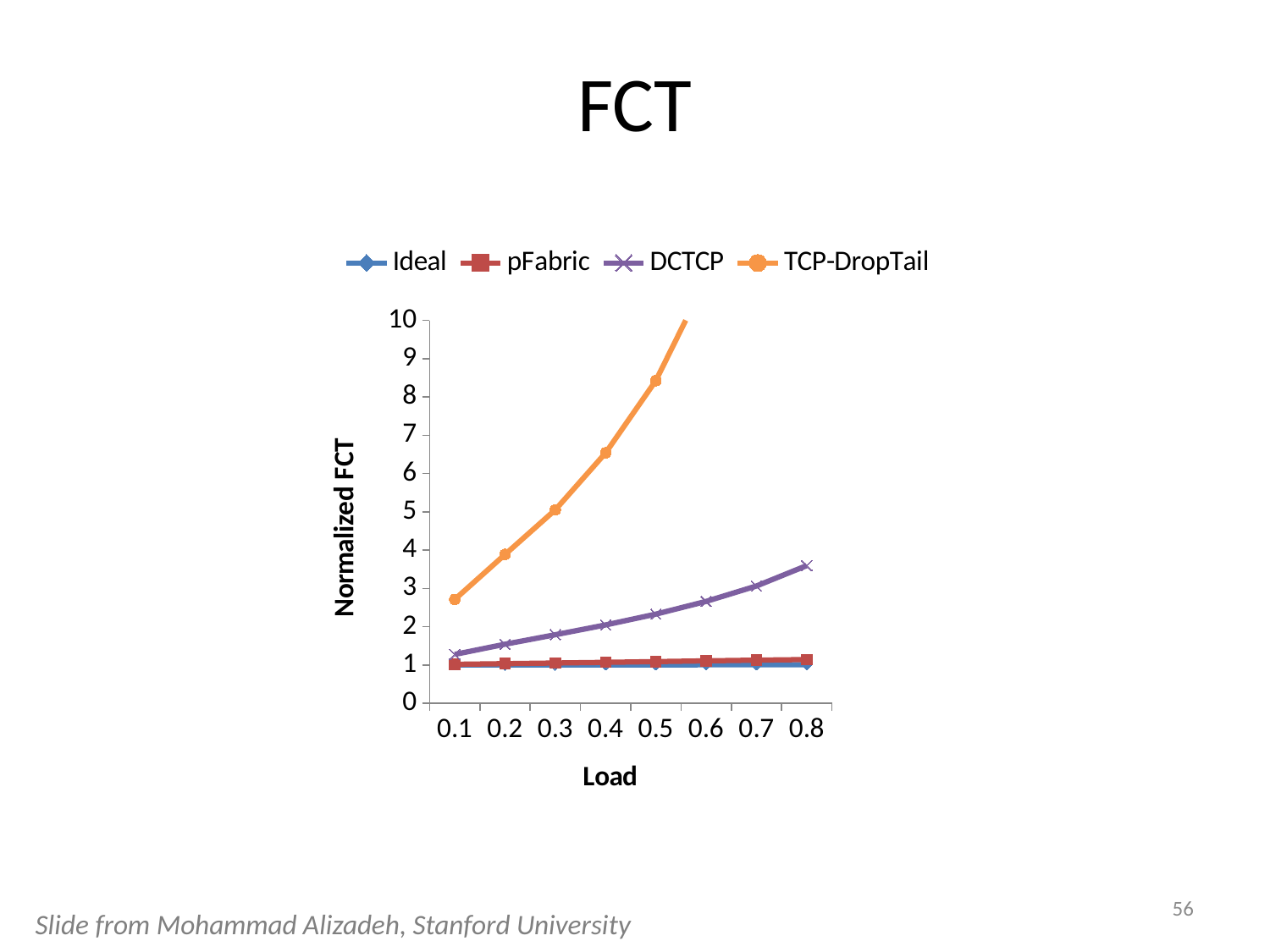
Is the Normalized FCT for TCP-DropTail at a Load of 0.5 greater or less than 8? greater How many Load values are marked on the x axis? 8 Is the Normalized FCT for DCTCP at a Load of 0.8 greater or less than 3? greater Is the Normalized FCT for DCTCP at a Load of 0.1 greater or less than 2? less What kind of chart is shown on the slide? line chart What is the label of the y axis? Normalized FCT Which series has the lowest Normalized FCT at a Load of 0.8? Ideal Does the Normalized FCT for TCP-DropTail rise or fall as Load increases? rise Which series has the highest Normalized FCT at a Load of 0.5? TCP-DropTail How many series does the legend list? 4 At a Load of 0.4, which series has the larger Normalized FCT, DCTCP or TCP-DropTail? TCP-DropTail